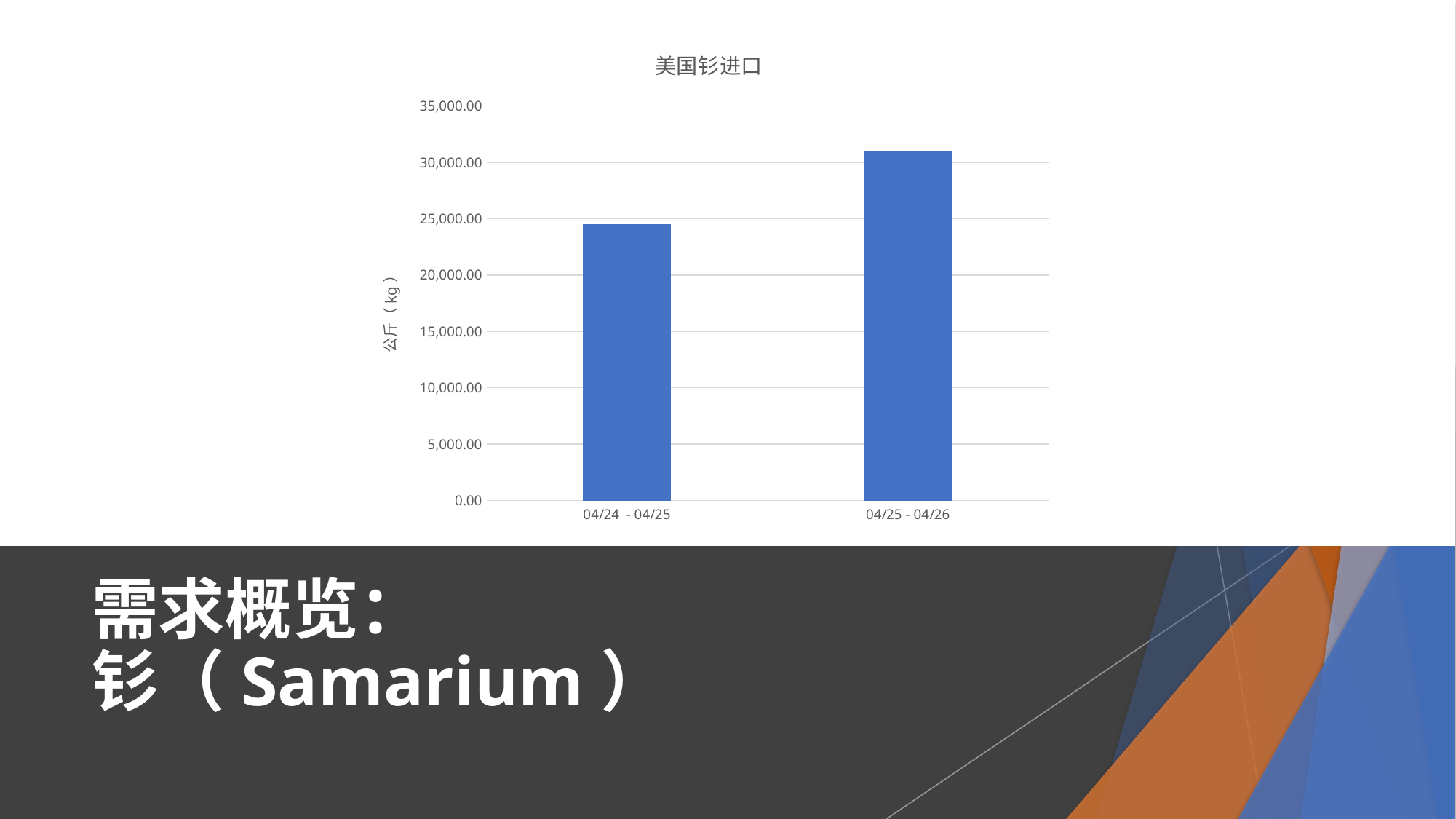
Is the value for 04/25 - 04/26 greater or less than 30,000.00? greater How many categories (bars) does the chart show? 2 Which period has the lowest value in the chart? 04/24 - 04/25 Which is larger, the value for 04/24 - 04/25 or the value for 04/25 - 04/26? 04/25 - 04/26 Is the value for 04/24 - 04/25 greater or less than 20,000.00? greater Is the value for 04/25 - 04/26 greater or less than 35,000.00? less What kind of chart is shown on the slide? bar chart Do the values rise or fall from 04/24 - 04/25 to 04/25 - 04/26? rise What is the title of the chart? 美国钐进口 What is the label of the vertical axis? 公斤（kg） Which period has the highest value in the chart? 04/25 - 04/26